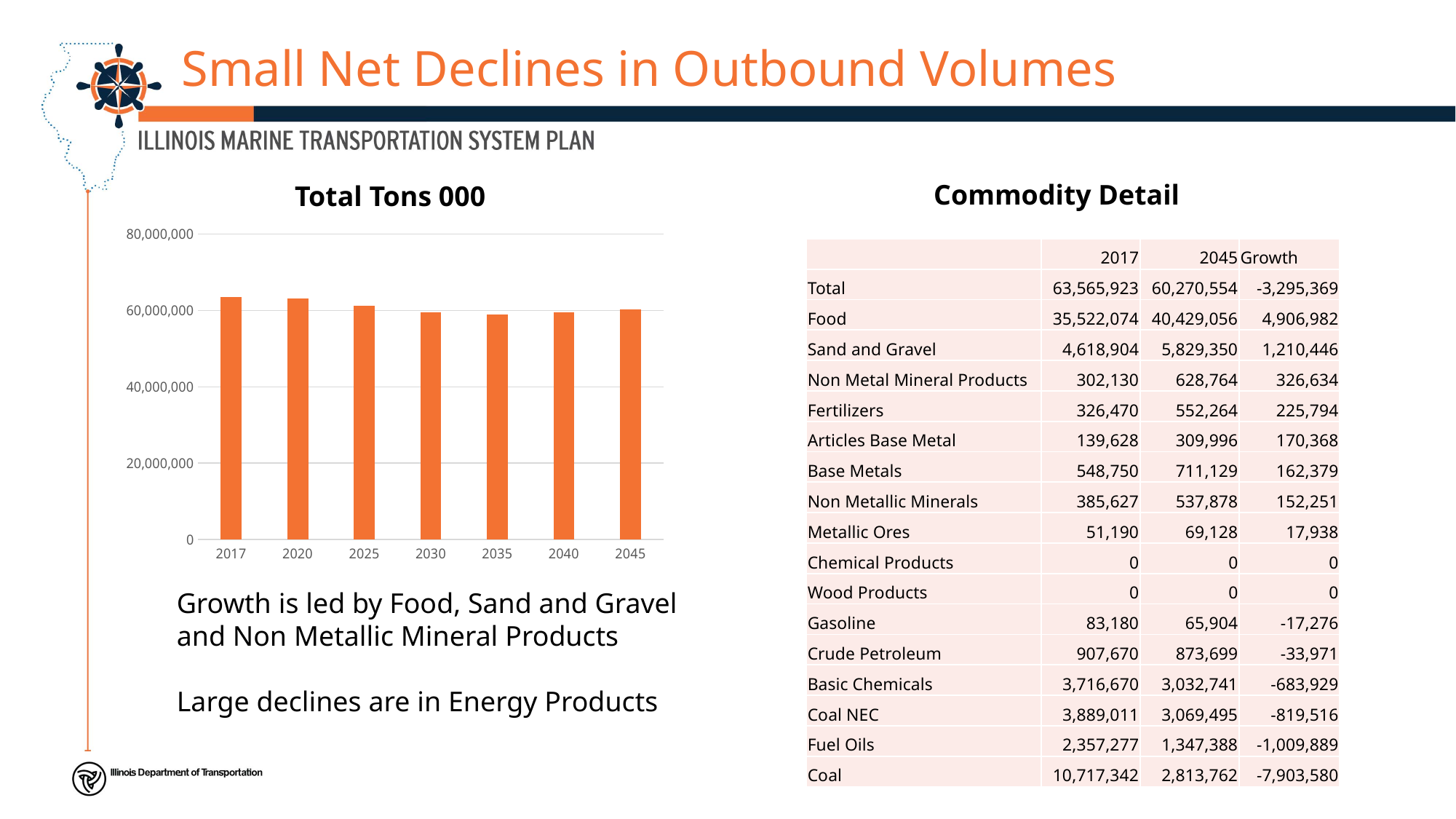
In the "Total Tons 000" chart, is the value for 2017 greater or less than 60,000,000? greater What colour are the bars in the "Total Tons 000" chart? orange In the "Total Tons 000" chart, do the values generally rise or fall from 2017 to 2035? fall What kind of chart is shown under the title "Total Tons 000"? bar chart In the "Total Tons 000" chart, is the value for 2045 greater or less than 80,000,000? less What is the first year shown on the x axis of the "Total Tons 000" chart? 2017 How many years are plotted on the "Total Tons 000" chart? 7 In the "Total Tons 000" chart, which is larger, the bar for 2017 or the bar for 2035? 2017 In the "Total Tons 000" chart, which is larger, the bar for 2020 or the bar for 2030? 2020 In the "Total Tons 000" chart, is the value for 2030 greater or less than 40,000,000? greater What is the highest value labelled on the y axis of the "Total Tons 000" chart? 80,000,000